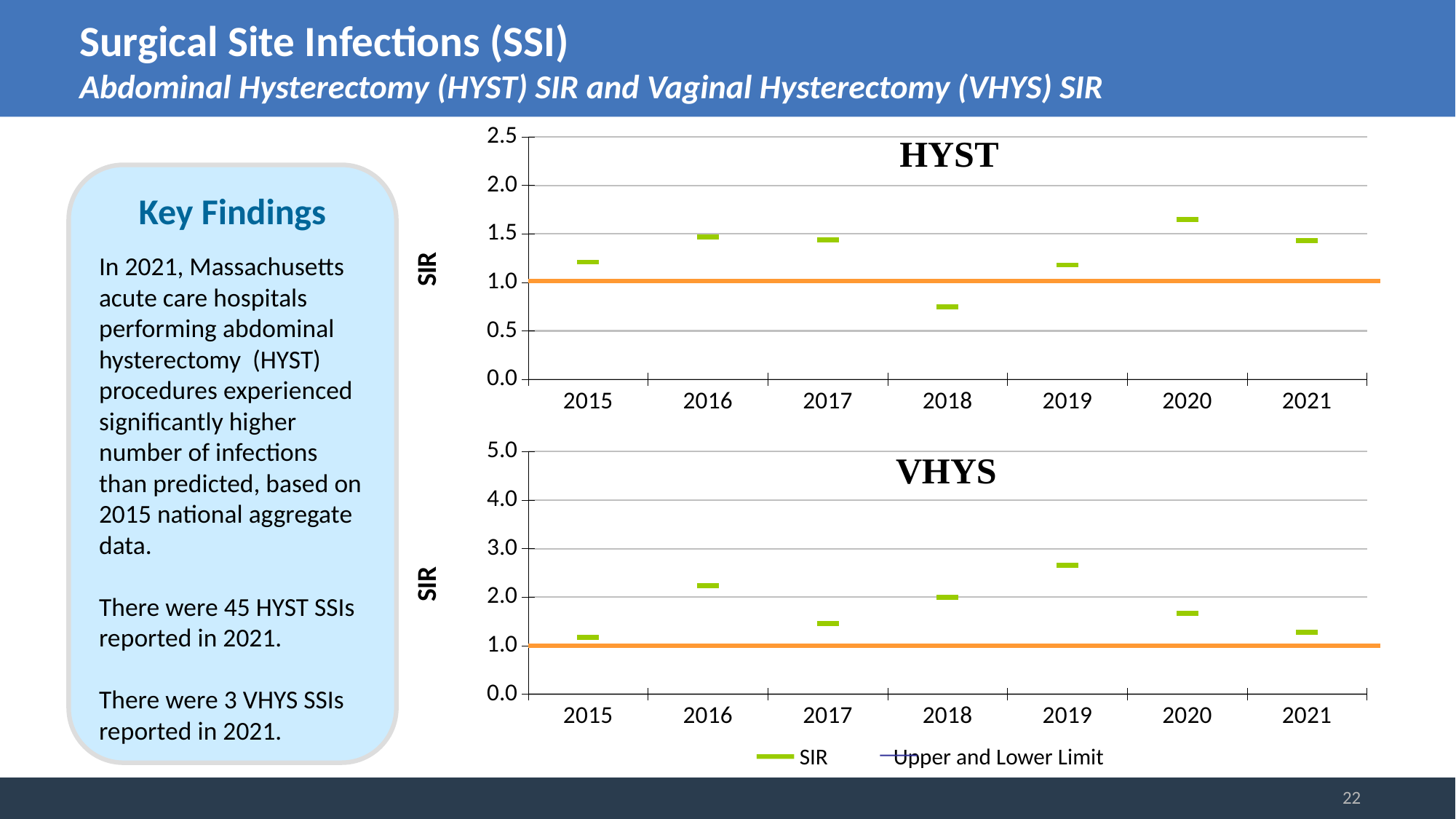
In the HYST chart, which year has the lowest SIR value? 2018 In the HYST chart, is the SIR value for 2020 greater or less than 1.5? greater In the HYST chart, which year has a larger SIR value, 2016 or 2018? 2016 How many years are plotted on the x axis of the HYST chart? 7 What is the label on the y axis of the HYST chart? SIR In the HYST chart, is the SIR value for 2018 greater or less than 1.0? less In the VHYS chart, which year has a larger SIR value, 2019 or 2021? 2019 How many entries does the legend below the VHYS chart list? 2 In the VHYS chart, is the SIR value for 2017 greater or less than 2.0? less In the VHYS chart, which year has the highest SIR value? 2019 In the HYST chart, which year has the highest SIR value? 2020